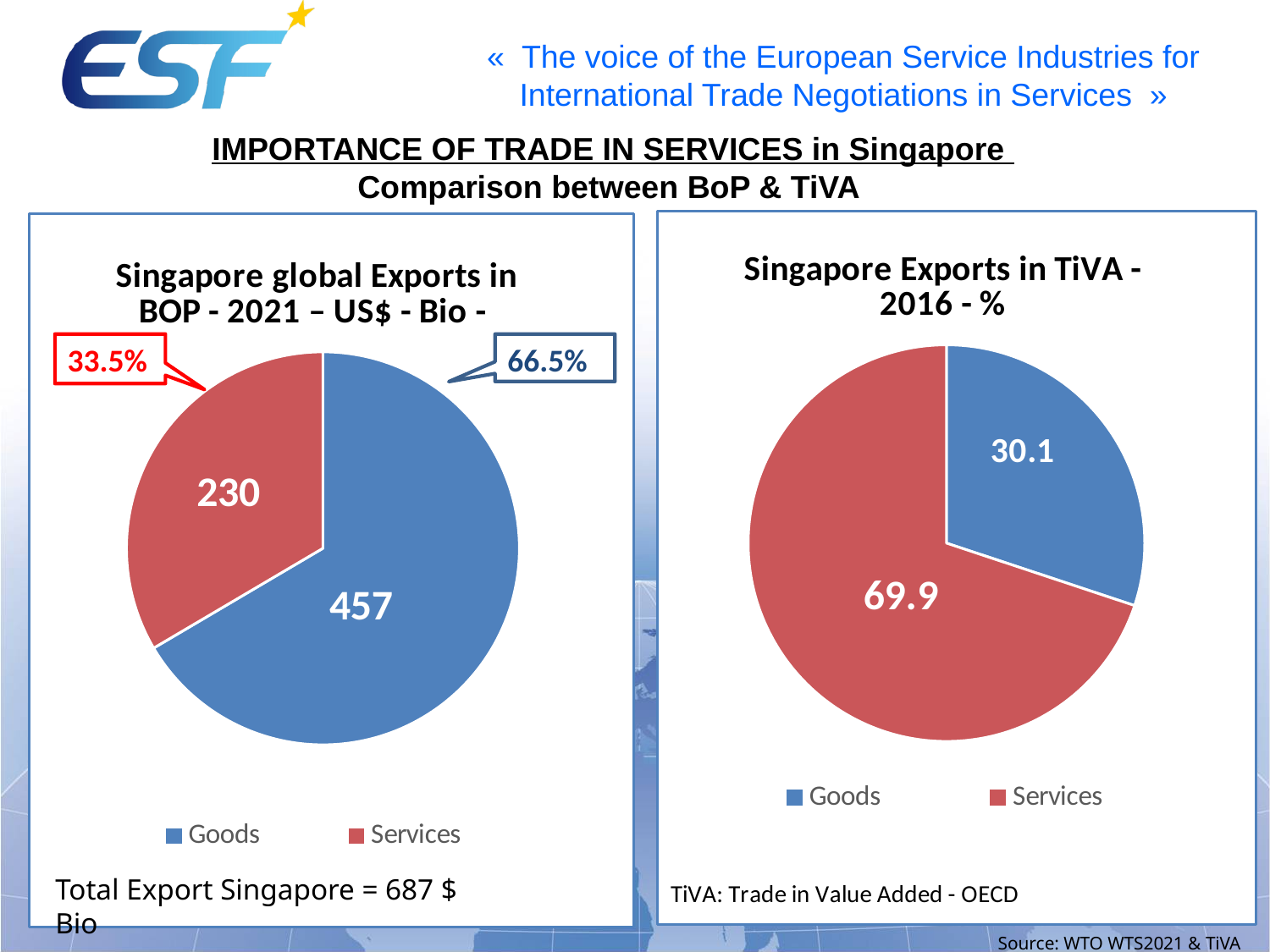
In the 'Singapore global Exports in BOP - 2021' chart, what percentage share is shown for Goods? 66.5% In the 'Singapore global Exports in BOP - 2021' chart, what percentage share is shown for Services? 33.5% In the 'Singapore Exports in TiVA - 2016 - %' chart, what is the value for Goods? 30.1 In the 'Singapore global Exports in BOP - 2021' chart, what is the value for Goods? 457 What type of chart is the 'Singapore Exports in TiVA - 2016 - %' chart? pie chart In the 'Singapore global Exports in BOP - 2021' chart, what is the difference between the Goods and Services values? 227 In the 'Singapore global Exports in BOP - 2021' chart, what is the value for Services? 230 In the 'Singapore global Exports in BOP - 2021' chart, which category has the larger slice? Goods In the 'Singapore Exports in TiVA - 2016 - %' chart, which category has the smaller slice? Goods How many categories does the legend of the 'Singapore global Exports in BOP - 2021' chart list? 2 In the 'Singapore Exports in TiVA - 2016 - %' chart, what is the value for Services? 69.9 In the 'Singapore Exports in TiVA - 2016 - %' chart, is the value for Services larger or smaller than the value for Goods? larger